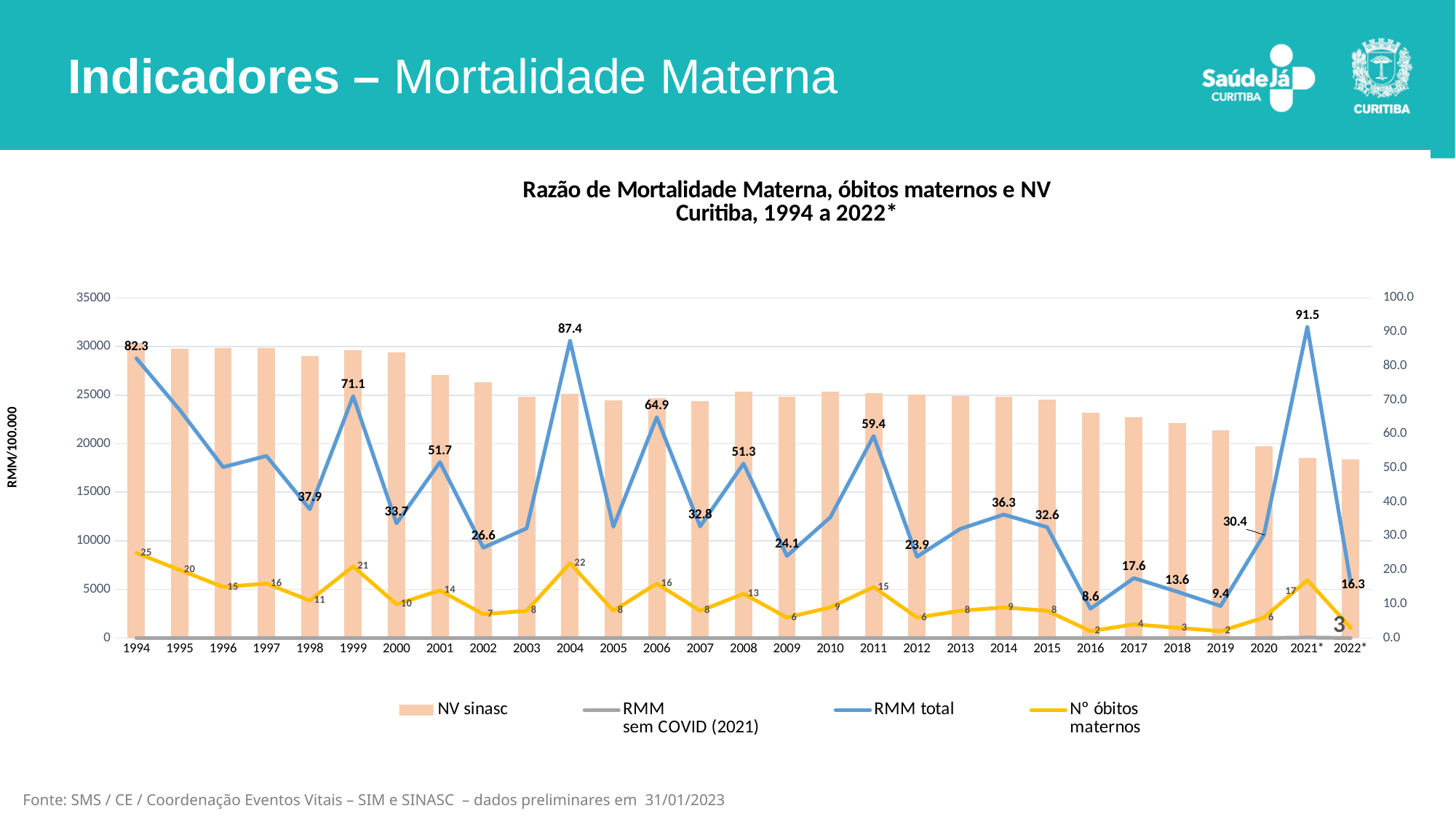
Is the NV sinasc value for 2021* greater or less than 20000? less Which year has a higher RMM total, 1999 or 2006? 1999 In which year is the RMM total highest? 2021* How many maternal deaths (Nº óbitos maternos) are shown for 2004? 22 How many years are shown on the x axis? 29 Is the NV sinasc value for 1994 greater or less than 25000? greater What kind of chart is shown on the slide? Combination bar and line chart What is the difference between the RMM total in 2021* and in 2022*? 75.2 What is the RMM total value for 2016? 8.6 What is the RMM total value for 2021*? 91.5 In which year is the number of maternal deaths (Nº óbitos maternos) highest? 1994 How many series does the legend list? 4